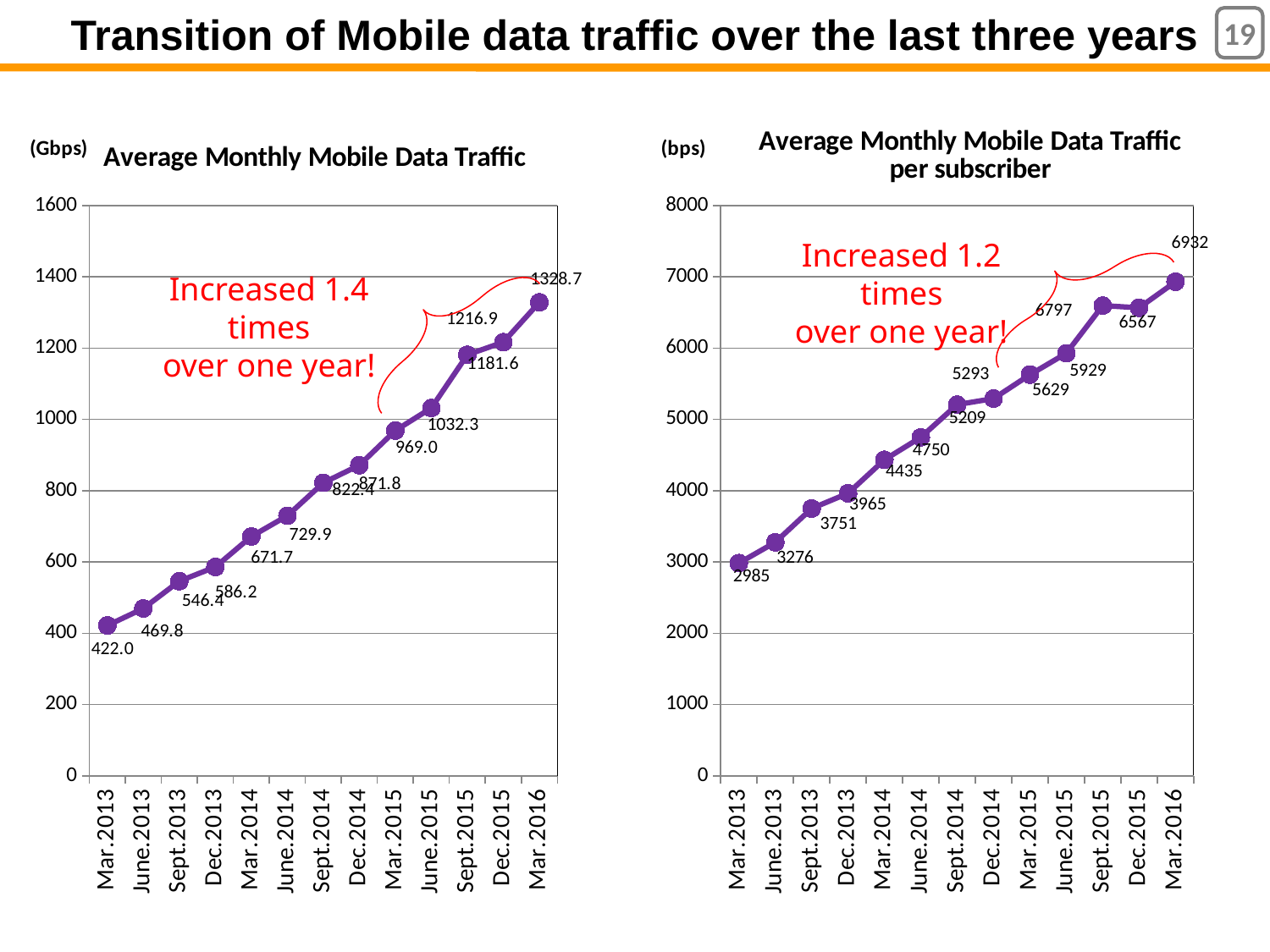
In the 'Average Monthly Mobile Data Traffic per subscriber' chart on the right, what is the value for Dec.2015? 6567 In the 'Average Monthly Mobile Data Traffic' chart on the left, is the value for June.2015 greater or less than 1000? greater In the 'Average Monthly Mobile Data Traffic per subscriber' chart on the right, which period has the highest value? Mar.2016 In the 'Average Monthly Mobile Data Traffic' chart on the left, what is the value for Mar.2013? 422.0 What type of chart is the 'Average Monthly Mobile Data Traffic per subscriber' chart on the right? Line chart In the 'Average Monthly Mobile Data Traffic' chart on the left, which period has the lowest value? Mar.2013 In the 'Average Monthly Mobile Data Traffic' chart on the left, what is the value for Mar.2016? 1328.7 In the 'Average Monthly Mobile Data Traffic per subscriber' chart on the right, what is the value for Mar.2016? 6932 In the 'Average Monthly Mobile Data Traffic per subscriber' chart on the right, which is larger, the value for Sept.2015 or the value for Dec.2015? Sept.2015 What unit is shown for the 'Average Monthly Mobile Data Traffic per subscriber' chart on the right? bps In the 'Average Monthly Mobile Data Traffic' chart on the left, what is the difference between the Mar.2016 value and the Mar.2015 value? 359.7 How many data points are plotted in the 'Average Monthly Mobile Data Traffic' chart on the left? 13